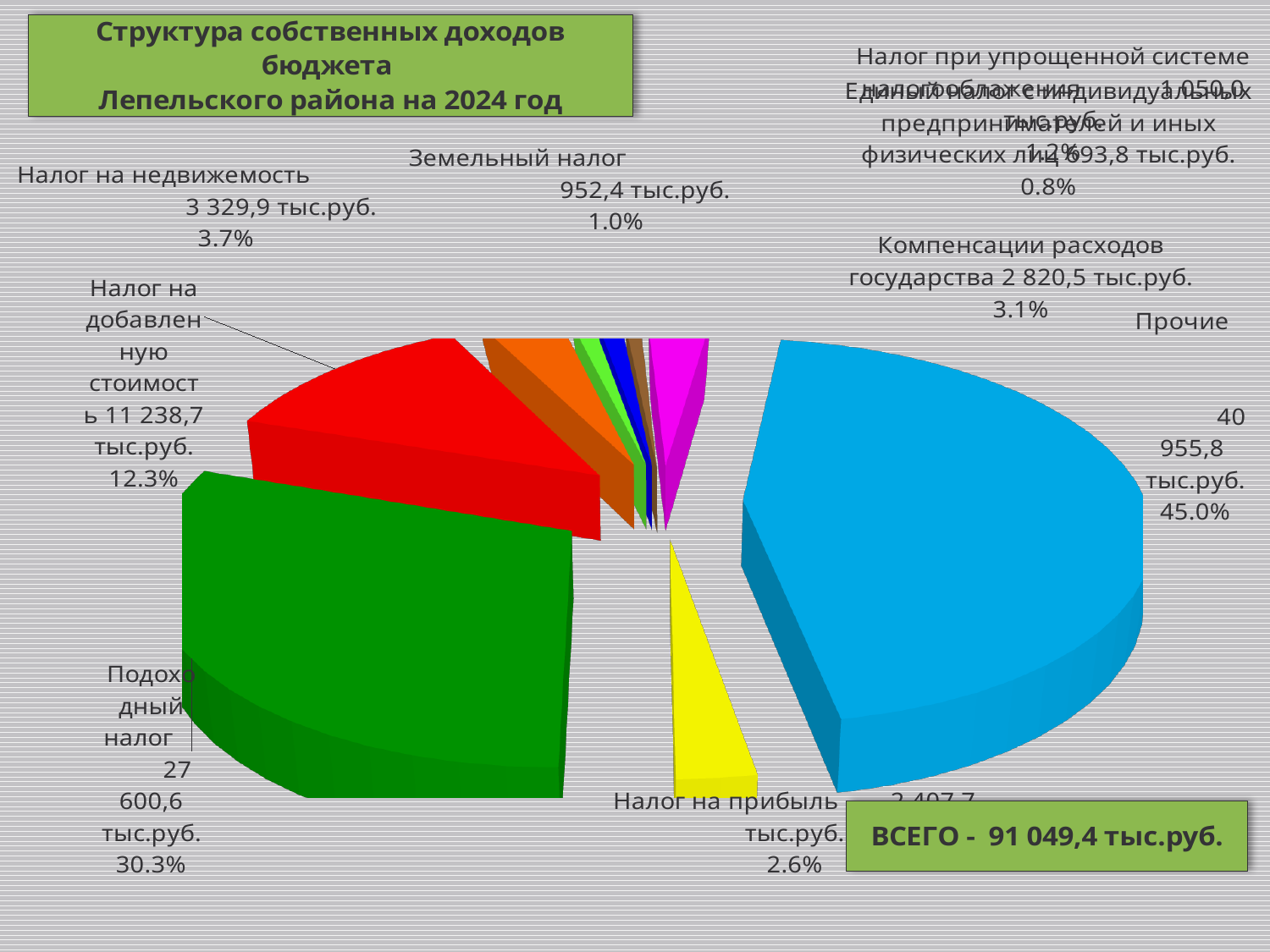
What is the value shown for Налог на недвижимость? 3 329,9 тыс.руб. What total (ВСЕГО) is stated on the slide? 91 049,4 тыс.руб. What share of the pie does Налог на прибыль have? 2.6% What is the value shown for Компенсации расходов государства? 2 820,5 тыс.руб. Which has the larger share: Налог на недвижимость or Компенсации расходов государства? Налог на недвижимость What share of the pie does Земельный налог have? 1.0% What kind of chart is shown on the slide? pie chart How many slices does the pie chart have? 9 What share of the pie does Подоходный налог have? 30.3% Which category has the largest share of the pie? Прочие By how many percentage points does the share of Подоходный налог exceed the share of Налог на добавленную стоимость? 18.0 percentage points What is the value shown for Налог на добавленную стоимость? 11 238,7 тыс.руб.